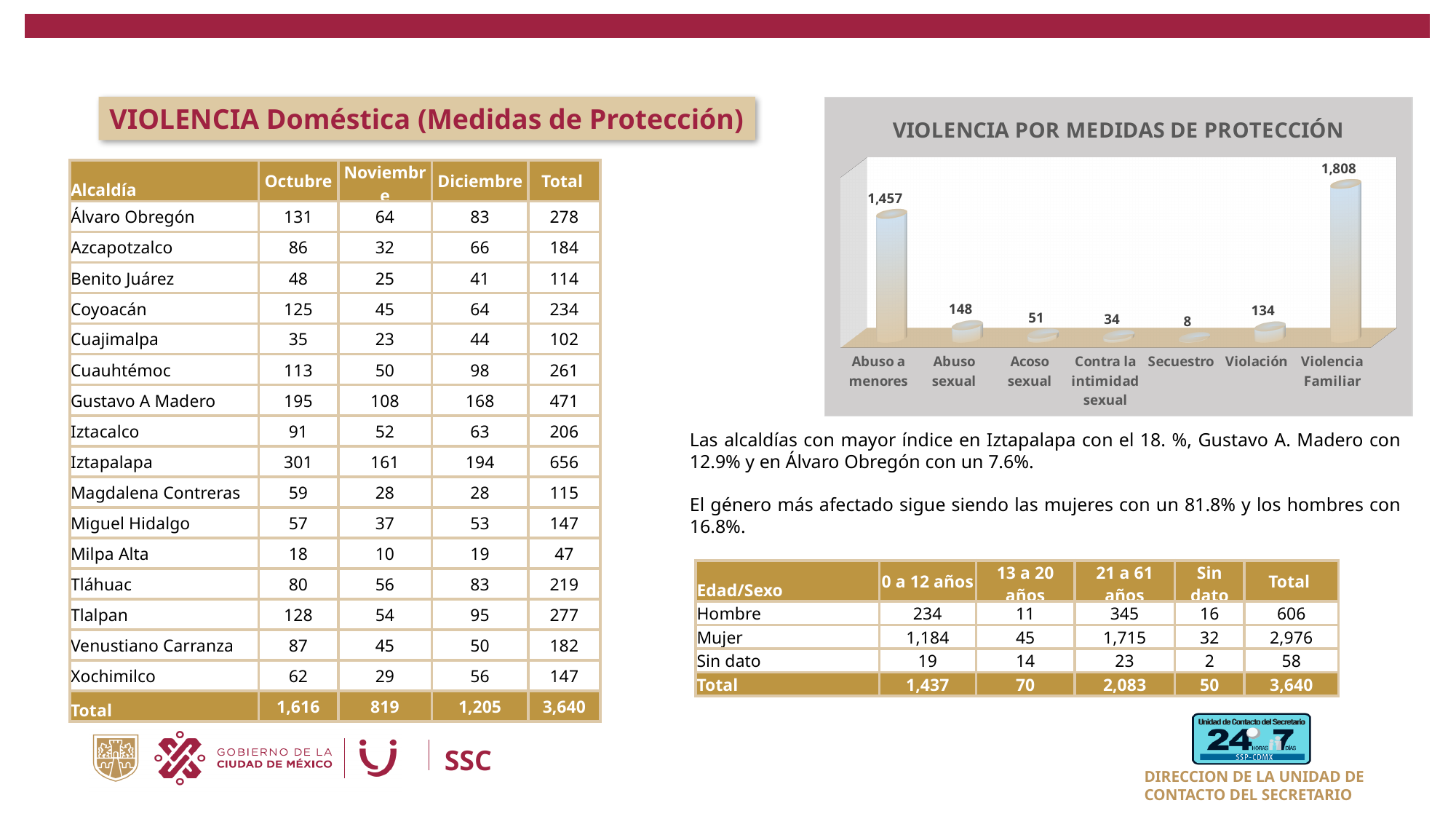
What is the value for Secuestro in the chart? 8 Which is larger, the value for Acoso sexual or the value for Contra la intimidad sexual? Acoso sexual Which category has the highest value in the chart? Violencia Familiar How many categories are shown in the chart? 7 What kind of chart is shown on the slide? Bar chart What is the difference between the values for Abuso sexual and Violación? 14 What is the value for Violación in the chart? 134 What is the value for Violencia Familiar in the chart? 1,808 What is the title of the chart on the slide? VIOLENCIA POR MEDIDAS DE PROTECCIÓN Which category has the lowest value in the chart? Secuestro What is the difference between the values for Violencia Familiar and Abuso a menores? 351 What is the value for Abuso a menores in the chart? 1,457